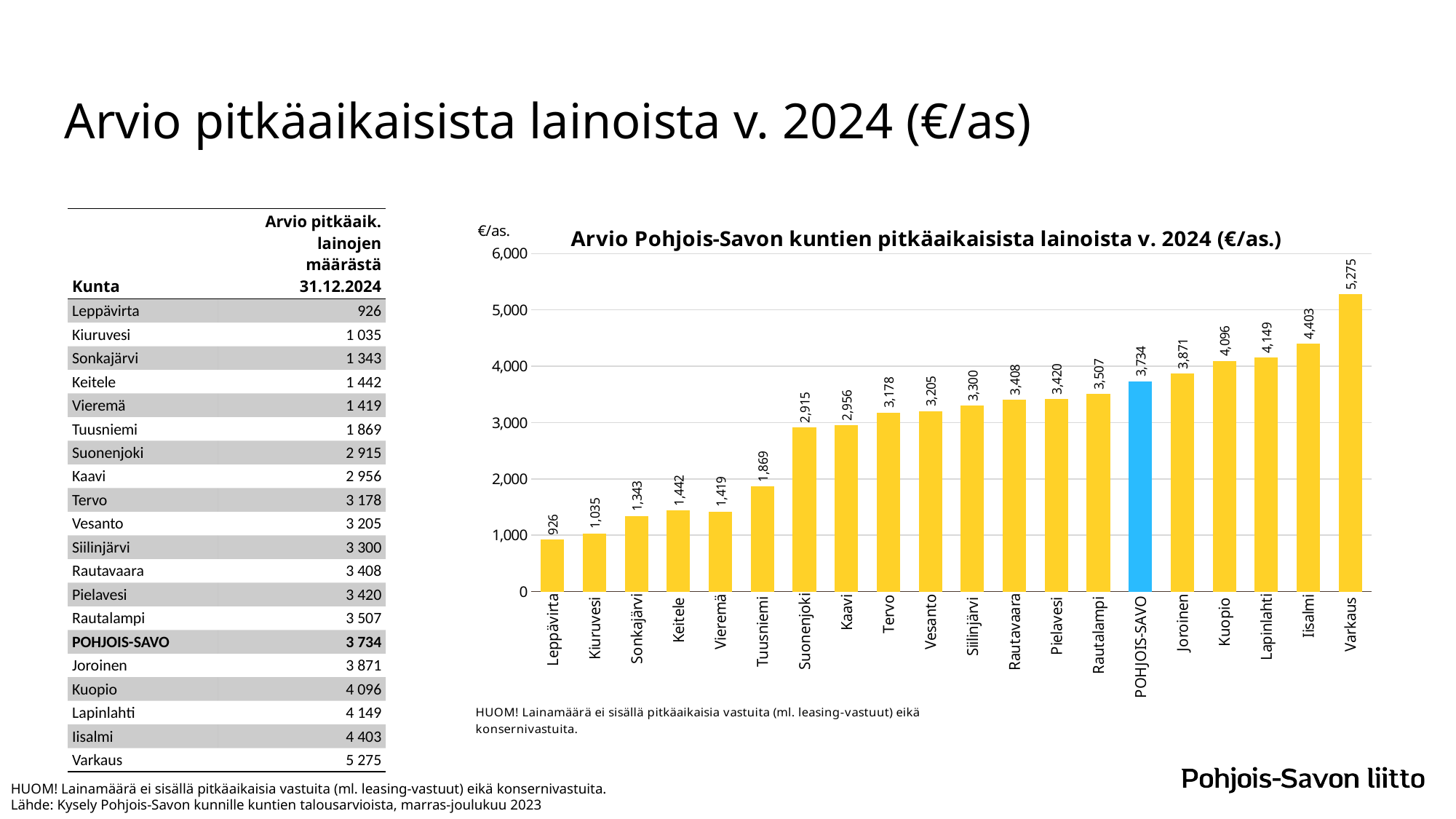
What type of chart is shown on the slide? bar chart Which bar in the chart is coloured blue instead of yellow? POHJOIS-SAVO How many bars are shown in the chart? 20 Is the value for Suonenjoki greater or less than 3,000? less What is the difference between the values for Kiuruvesi and Leppävirta? 109 What is the value for Kuopio in the chart? 4,096 What is the value for Tuusniemi in the chart? 1,869 Which municipality has the lowest value in the chart? Leppävirta What is the value for POHJOIS-SAVO in the chart? 3,734 Which is larger, the value for Joroinen or the value for Rautalampi? Joroinen What is the difference between the values for Varkaus and Iisalmi? 872 Which municipality has the highest value in the chart? Varkaus